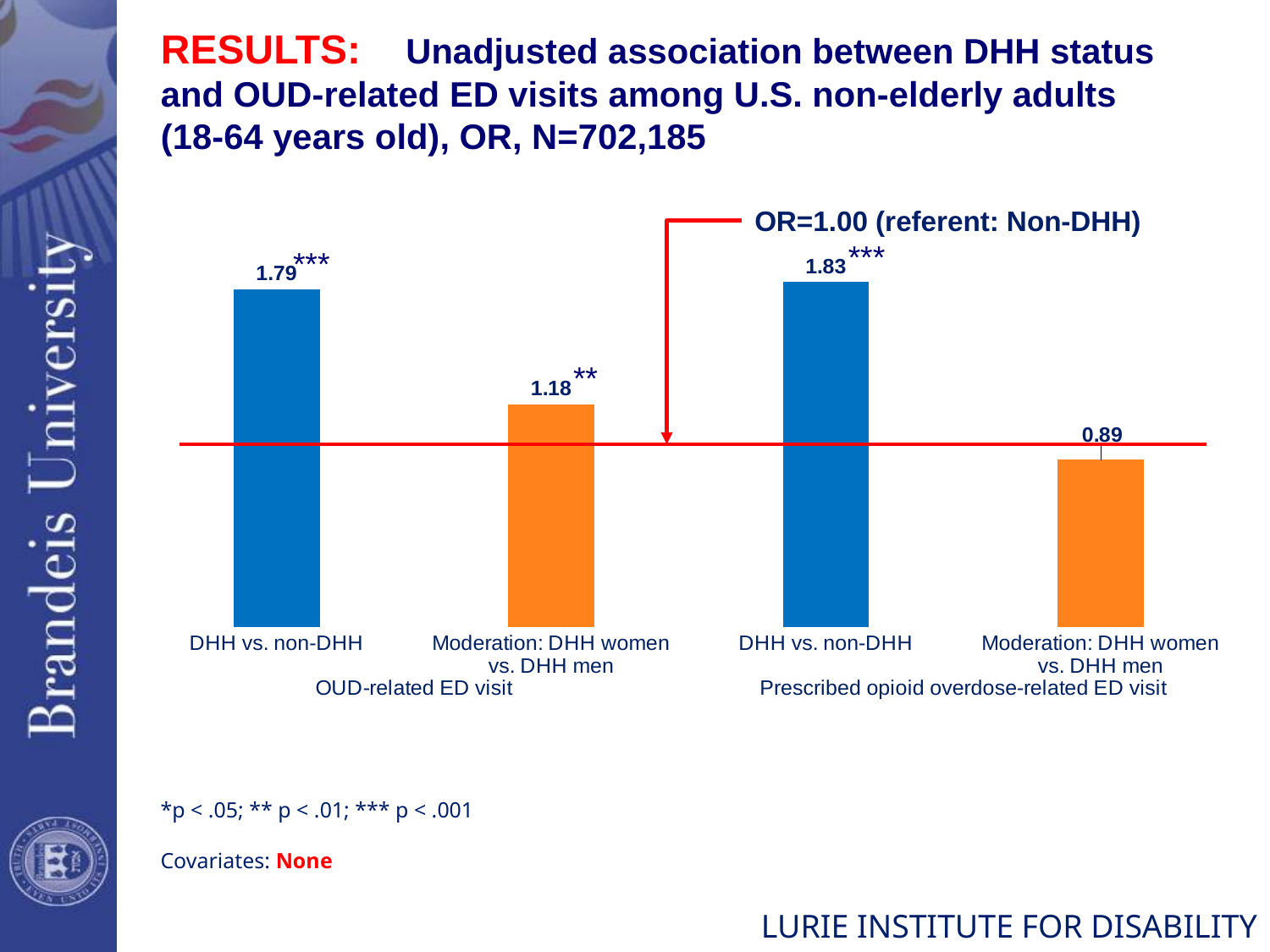
What is the odds ratio for DHH vs. non-DHH for OUD-related ED visit? 1.79 Which bar has the highest odds ratio on the chart? DHH vs. non-DHH (Prescribed opioid overdose-related ED visit) What value does the red horizontal reference line on the chart represent? OR=1.00 (referent: Non-DHH) What is the odds ratio for Moderation: DHH women vs. DHH men for Prescribed opioid overdose-related ED visit? 0.89 What is the odds ratio for DHH vs. non-DHH for Prescribed opioid overdose-related ED visit? 1.83 Which bar has the lowest odds ratio on the chart? Moderation: DHH women vs. DHH men (Prescribed opioid overdose-related ED visit) Which is larger: the Moderation: DHH women vs. DHH men odds ratio for OUD-related ED visit or for Prescribed opioid overdose-related ED visit? OUD-related ED visit What is the difference between the two odds ratios shown for OUD-related ED visit? 0.61 What kind of chart is shown on the slide? Bar chart What is the difference between the DHH vs. non-DHH odds ratios for Prescribed opioid overdose-related ED visit and OUD-related ED visit? 0.04 How many bars are plotted on the chart? 4 What is the odds ratio for Moderation: DHH women vs. DHH men for OUD-related ED visit? 1.18